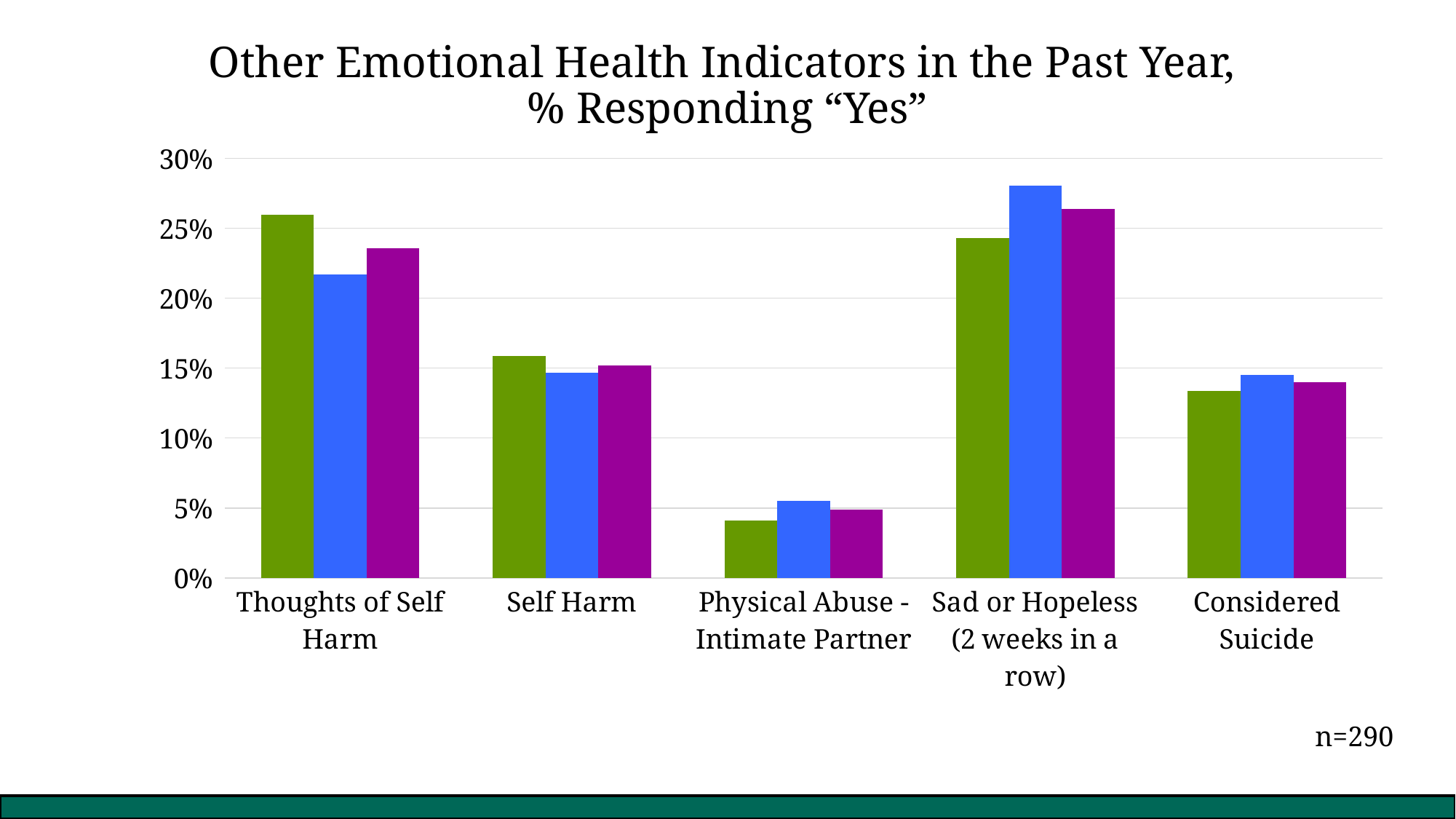
Is the value of the green bar for Considered Suicide greater or less than 15%? less What is the sample size noted on the slide? n=290 Is the value of the blue bar for Thoughts of Self Harm greater or less than 20%? greater Is the value of the blue bar for Sad or Hopeless (2 weeks in a row) greater or less than 25%? greater Which category has the lowest values across all three bars? Physical Abuse - Intimate Partner For Thoughts of Self Harm, which bar is taller, the green bar or the blue bar? the green bar How many categories are shown on the x axis of the chart? 5 Which category contains the tallest bar in the chart? Sad or Hopeless (2 weeks in a row) What kind of chart is shown on the slide? bar chart How many bars are plotted for each category in the chart? 3